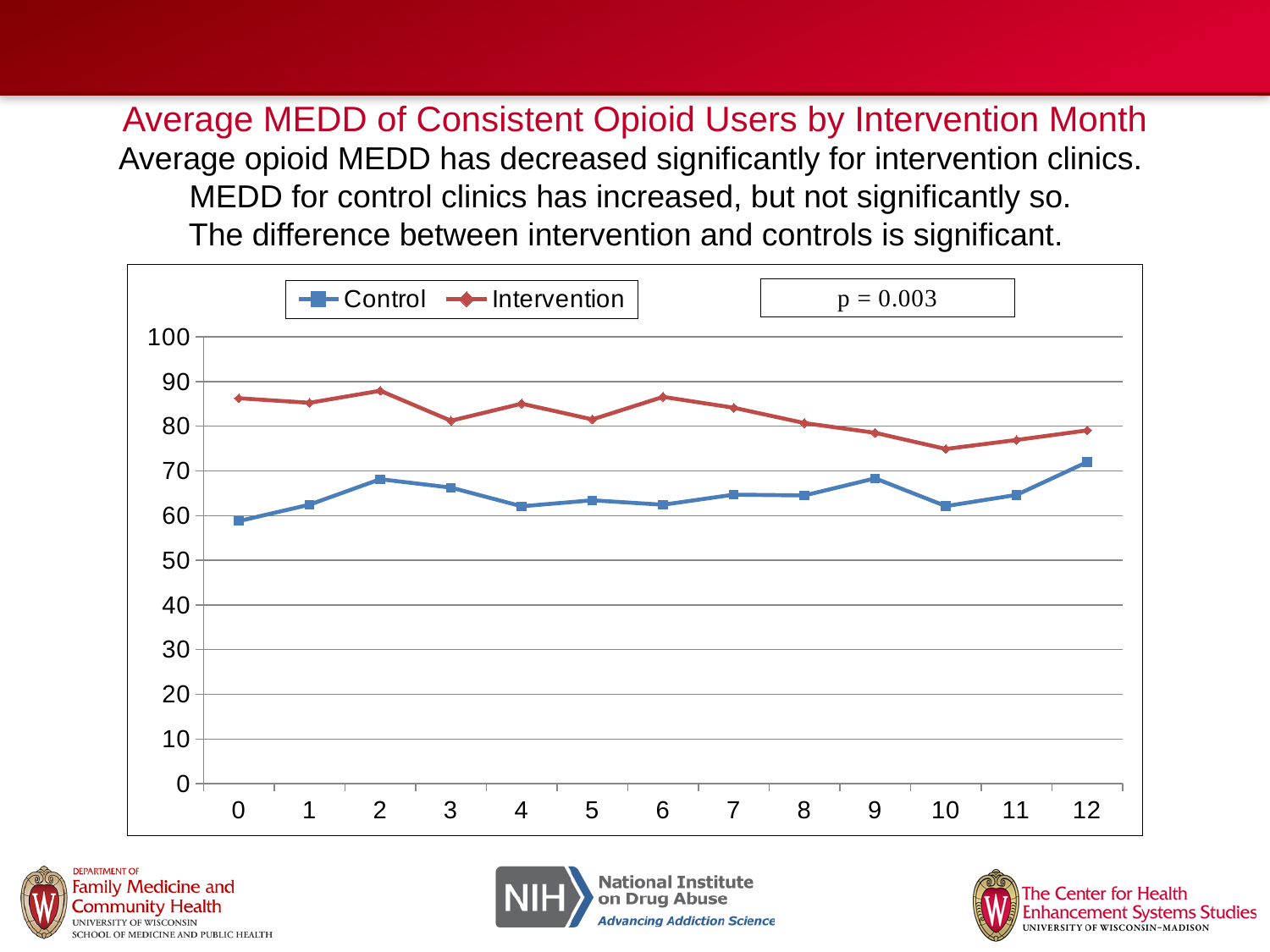
At which month is the Control series at its highest? 12 Is the Intervention value at month 2 greater or less than 80? greater Is the Intervention value at month 10 greater or less than 80? less How many intervention months are plotted along the x axis? 13 Is the Control value at month 12 greater or less than 70? greater Which series has the higher value at month 6, Control or Intervention? Intervention Does the Intervention series overall rise or fall from month 0 to month 12? fall How many series does the legend list? 2 At which month is the Control series at its lowest? 0 What kind of chart is shown on the slide? line chart What p-value is shown on the chart? p = 0.003 At which month is the Intervention series at its lowest? 10